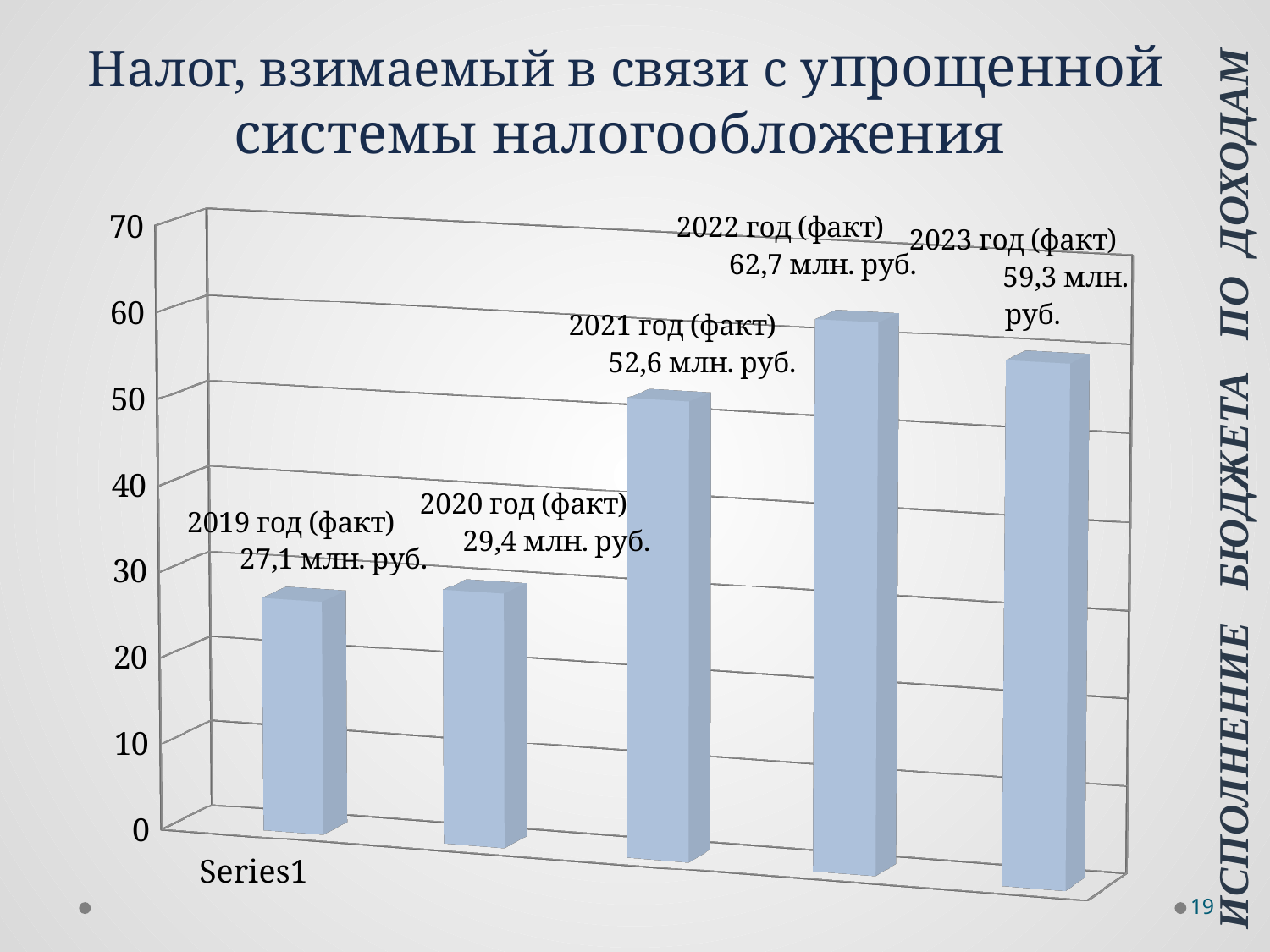
What is the value for 2023 год (факт)? 59,3 млн. руб. What kind of chart is shown on the slide? bar chart Is the value for 2020 год (факт) greater or less than 30? less Which year has the highest value? 2022 год (факт) What is the difference between the values for 2022 год (факт) and 2023 год (факт)? 3,4 млн. руб. What is the difference between the values for 2021 год (факт) and 2020 год (факт)? 23,2 млн. руб. How many bars are shown in the chart? 5 What is the value for 2019 год (факт)? 27,1 млн. руб. Which year has the lowest value? 2019 год (факт) What is the title of the chart? Налог, взимаемый в связи с упрощенной системы налогообложения What is the value for 2022 год (факт)? 62,7 млн. руб. Which is larger, the value for 2021 год (факт) or 2023 год (факт)? 2023 год (факт)